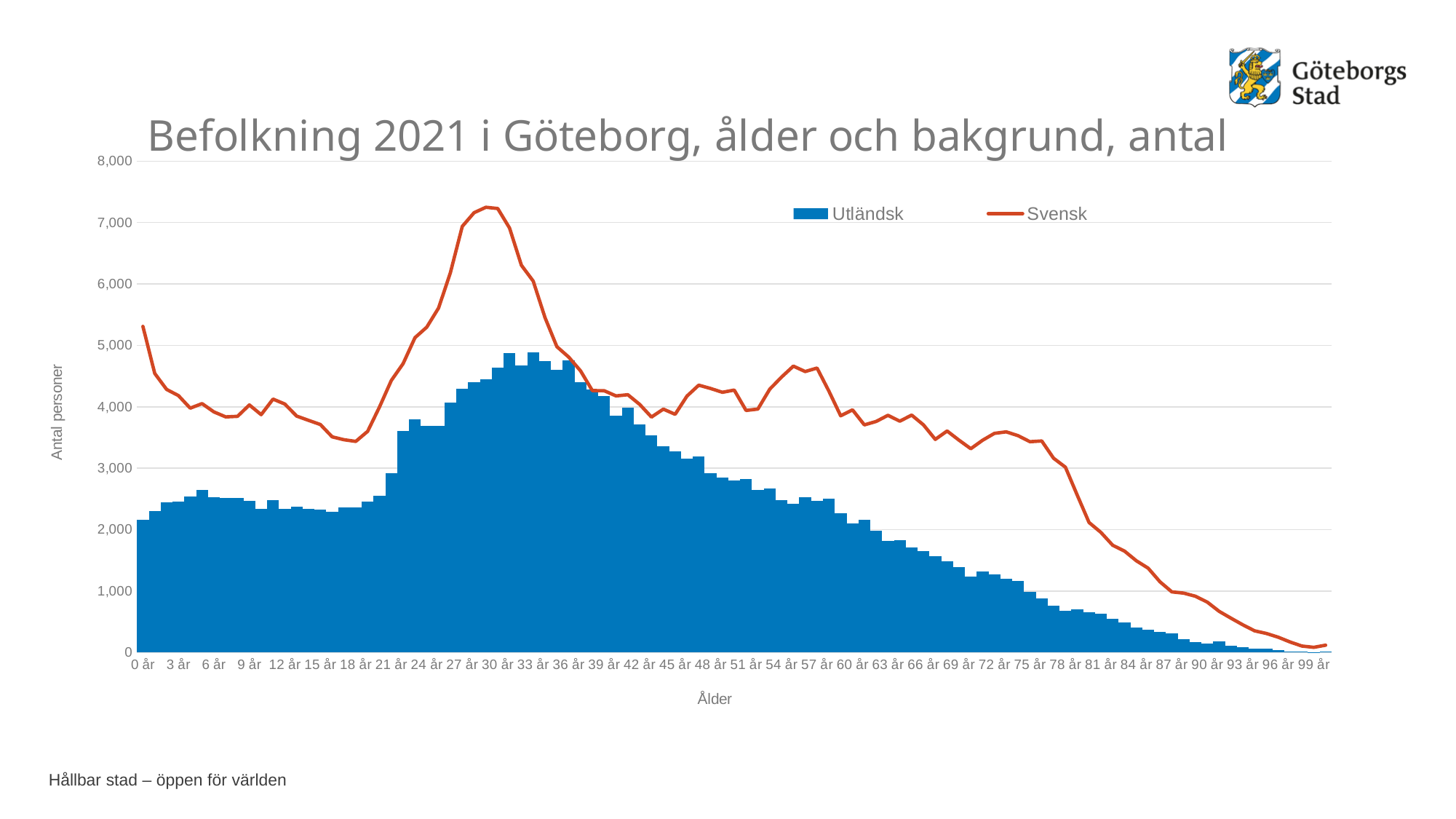
At 30 år, which is larger, the Svensk value or the Utländsk value? Svensk What kind of chart is shown on the slide? A combined bar and line chart Is the Svensk value at 0 år greater or less than 5,000? greater Is the Utländsk value at 33 år greater or less than 5,000? less Do the Utländsk values rise or fall from 60 år to 99 år? fall Which series is drawn as bars and which as a line? Utländsk is bars, Svensk is a line Is the Svensk value at 99 år greater or less than 1,000? less How many series does the legend list? 2 What is the title of the chart? Befolkning 2021 i Göteborg, ålder och bakgrund, antal